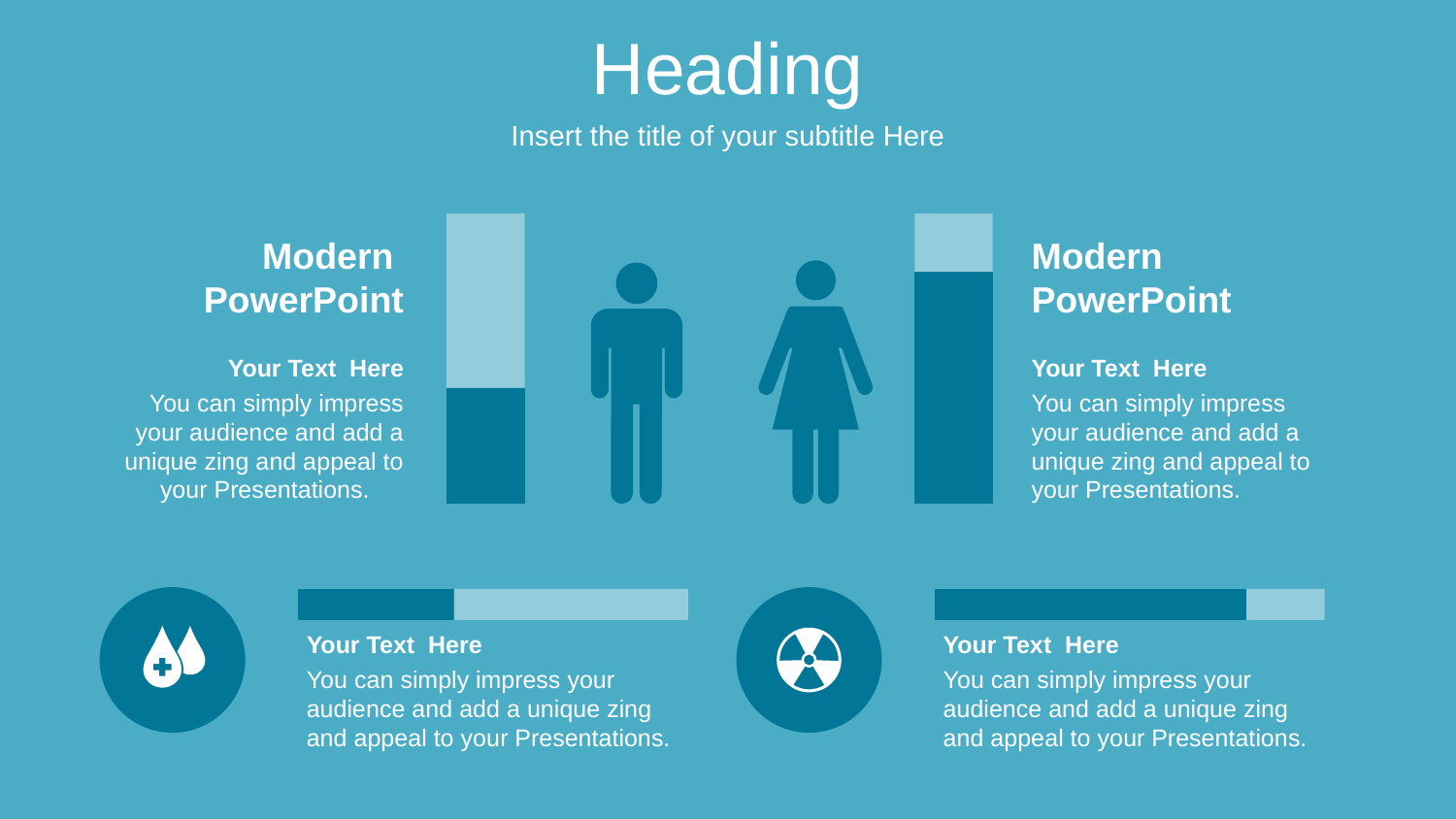
Is the dark-filled portion of the bottom-right horizontal bar greater or less than half of the bar? greater Is the dark-filled portion of the vertical bar beside the male figure greater or less than half of the bar? less What two colours are used to fill the bars on the slide? dark teal and light blue Is the dark-filled portion of the bottom-left horizontal bar greater or less than half of the bar? less What is the main heading at the top of the slide? Heading How many vertical bars are shown in the middle section of the slide? 2 Of the two horizontal bars at the bottom of the slide, which is filled further with the dark colour, the left one or the right one? the right one How many horizontal bars are shown in the bottom section of the slide? 2 Of the two vertical bars beside the male and female figures, which has the larger dark-filled portion? the bar beside the female figure